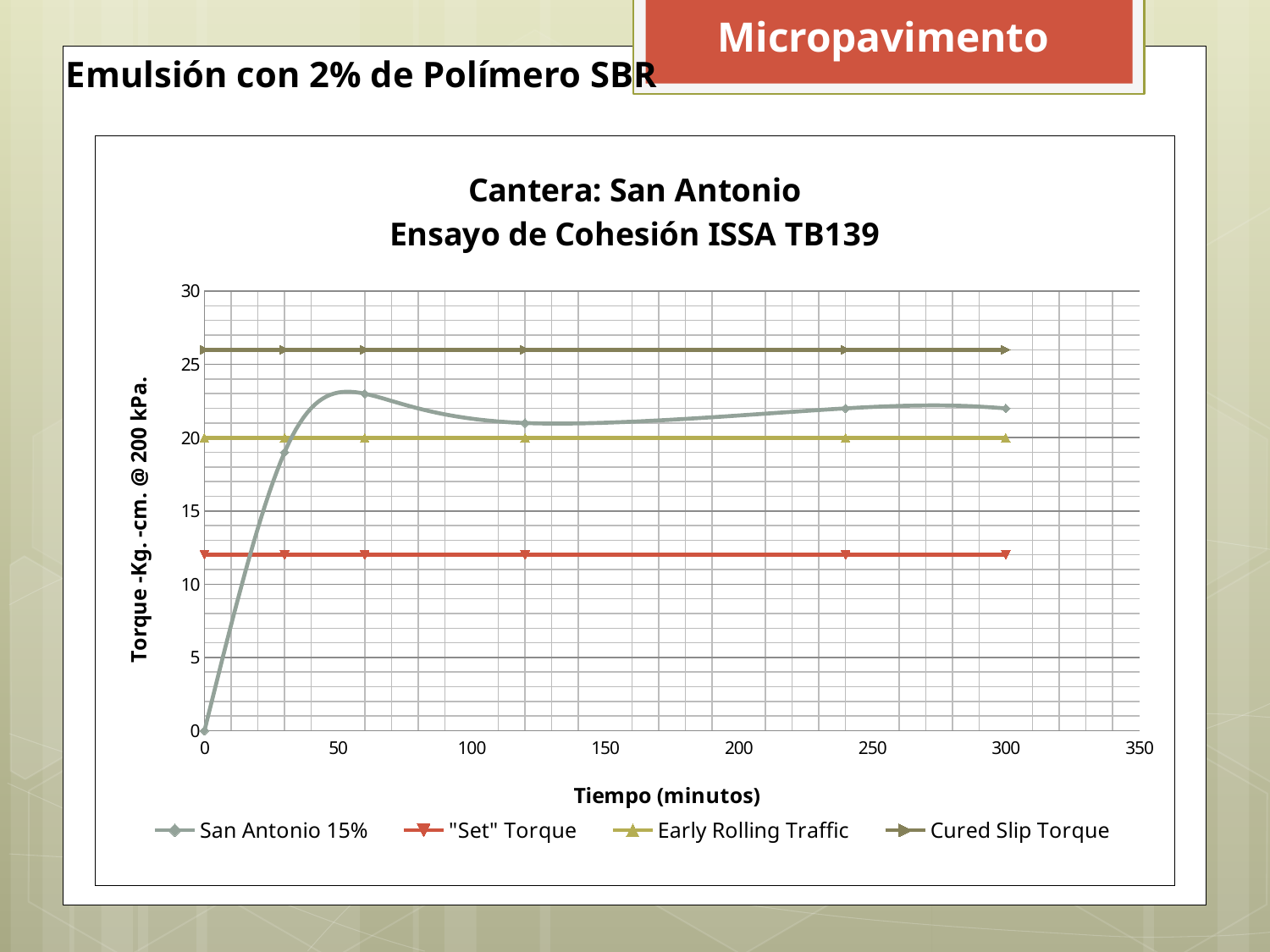
Is the value of the Cured Slip Torque line greater or less than 25? greater How many series does the legend list? 4 What is the value of the Early Rolling Traffic line? 20 What kind of chart is shown on the slide? line chart What is the value of the San Antonio 15% series at time 0 minutes? 0 Is the value of the "Set" Torque line greater or less than 10? greater Is the value of the San Antonio 15% series at 60 minutes greater or less than 20? greater Does the San Antonio 15% series rise or fall between 0 and 60 minutes? rise Which series has the lowest constant value? "Set" Torque What is the label of the x axis? Tiempo (minutos) Which horizontal reference line is the highest: "Set" Torque, Early Rolling Traffic or Cured Slip Torque? Cured Slip Torque